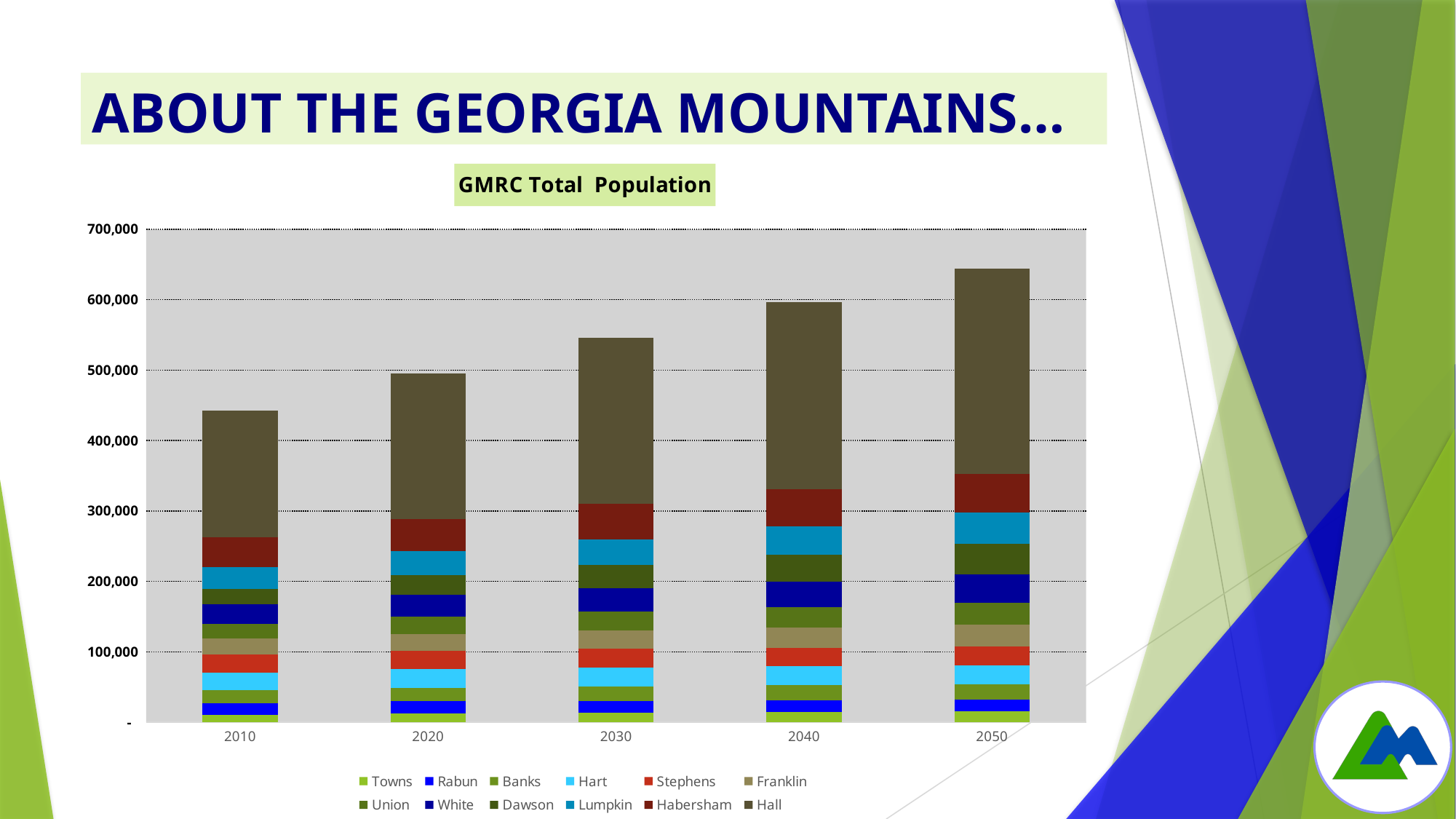
Do the total population values rise or fall from 2010 to 2050? Rise Is the total population for 2010 greater or less than 500,000? less What kind of chart is shown on the slide? Stacked bar chart Is the total population for 2050 greater or less than 600,000? greater Which is larger, the total population for 2040 or for 2020? 2040 What is the title of the chart? GMRC Total Population How many years are shown along the x axis of the chart? 5 Is the total population for 2030 greater or less than 500,000? greater Which county makes up the largest segment of each stacked bar? Hall Which year has the lowest total population in the chart? 2010 Which year has the highest total population in the chart? 2050 How many series does the chart's legend list? 12